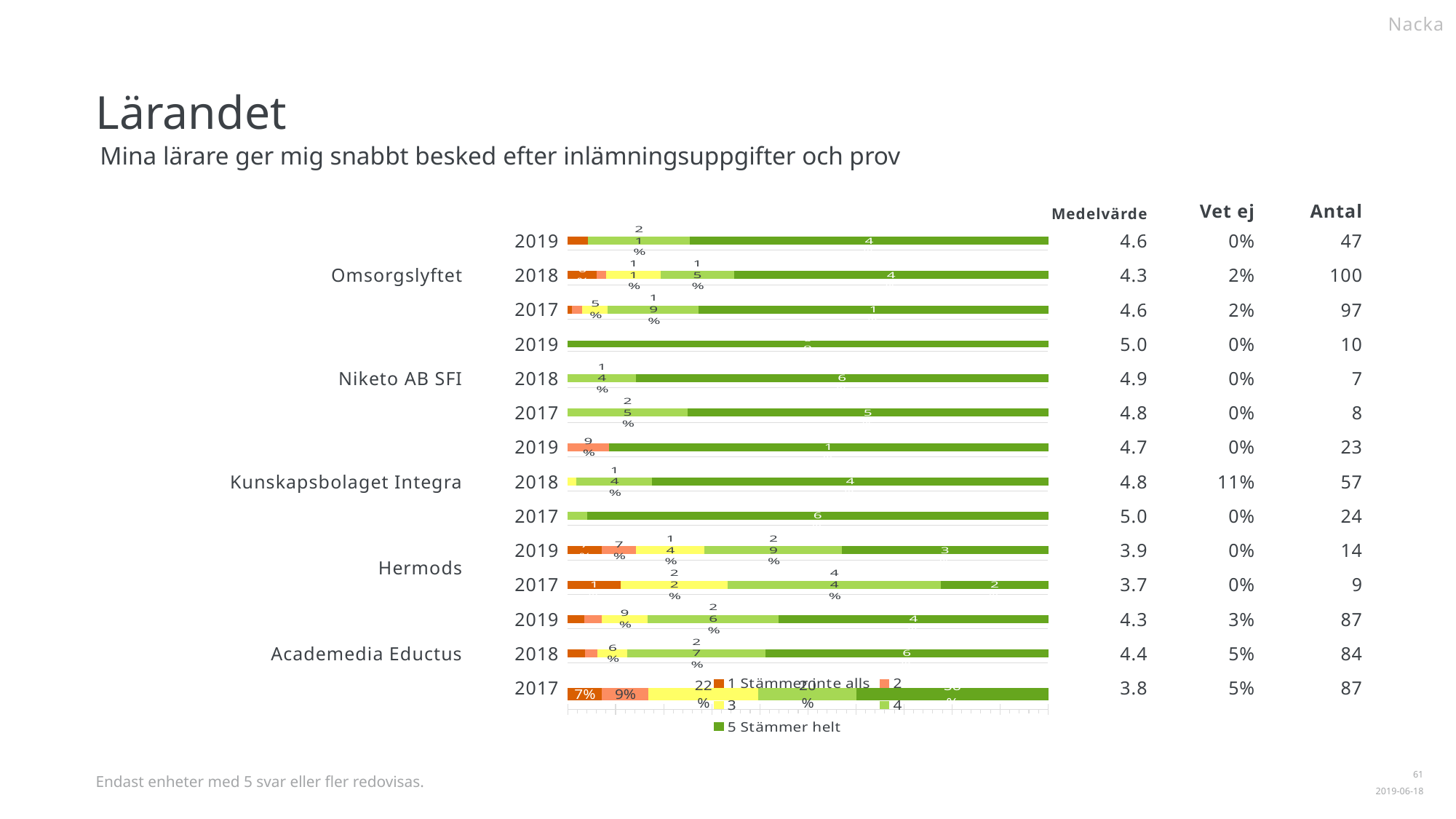
What kind of chart is shown on the slide? Stacked bar chart What percentage of Academedia Eductus 2017 respondents answered '1 Stämmer inte alls'? 7% Is the Medelvärde for Omsorgslyftet 2019 larger or smaller than for Hermods 2019? Larger Which unit and year has the highest Antal (number of respondents)? Omsorgslyftet 2018 How many bars (year rows) are plotted in the chart? 14 What percentage of Academedia Eductus 2017 respondents answered '2'? 9% Which unit and year has the highest Vet ej percentage? Kunskapsbolaget Integra 2018 What is the label of the first legend entry (the dark orange series)? 1 Stämmer inte alls What is the Medelvärde (mean) for Hermods 2017? 3.7 What percentage of Academedia Eductus 2017 respondents answered '3'? 22% What is the label of the last legend entry (the dark green series)? 5 Stämmer helt How many series does the chart legend list? 5